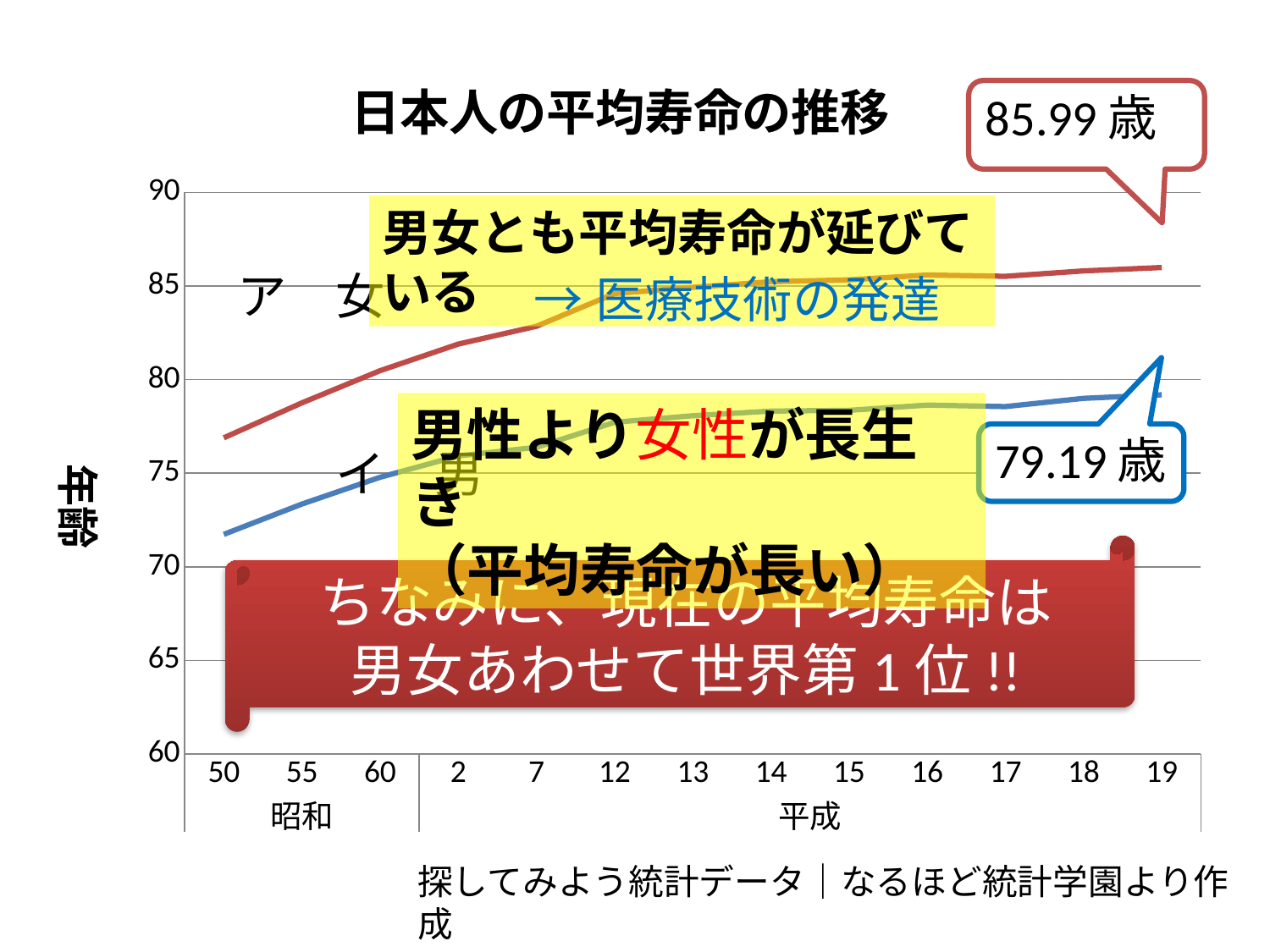
Is the value for 男 (men) at 平成19 greater or less than 75? greater What is the title of the chart? 日本人の平均寿命の推移 Which line is higher throughout the chart, 女 (women) or 男 (men)? 女 Is the value for 男 (men) at 昭和50 greater or less than 75? less What is the label on the vertical axis of the chart? 年齢 Do the life expectancy values rise or fall from 昭和50 to 平成19? rise What kind of chart is shown on the slide? line chart What is the average life expectancy for women (女) at 平成19 according to the callout? 85.99 歳 What is the difference between the women's and men's life expectancy at 平成19? 6.80 歳 Is the value for 女 (women) at 昭和50 greater or less than 80? less What is the average life expectancy for men (男) at 平成19 according to the callout? 79.19 歳 How many points are marked along the x axis of the chart? 13